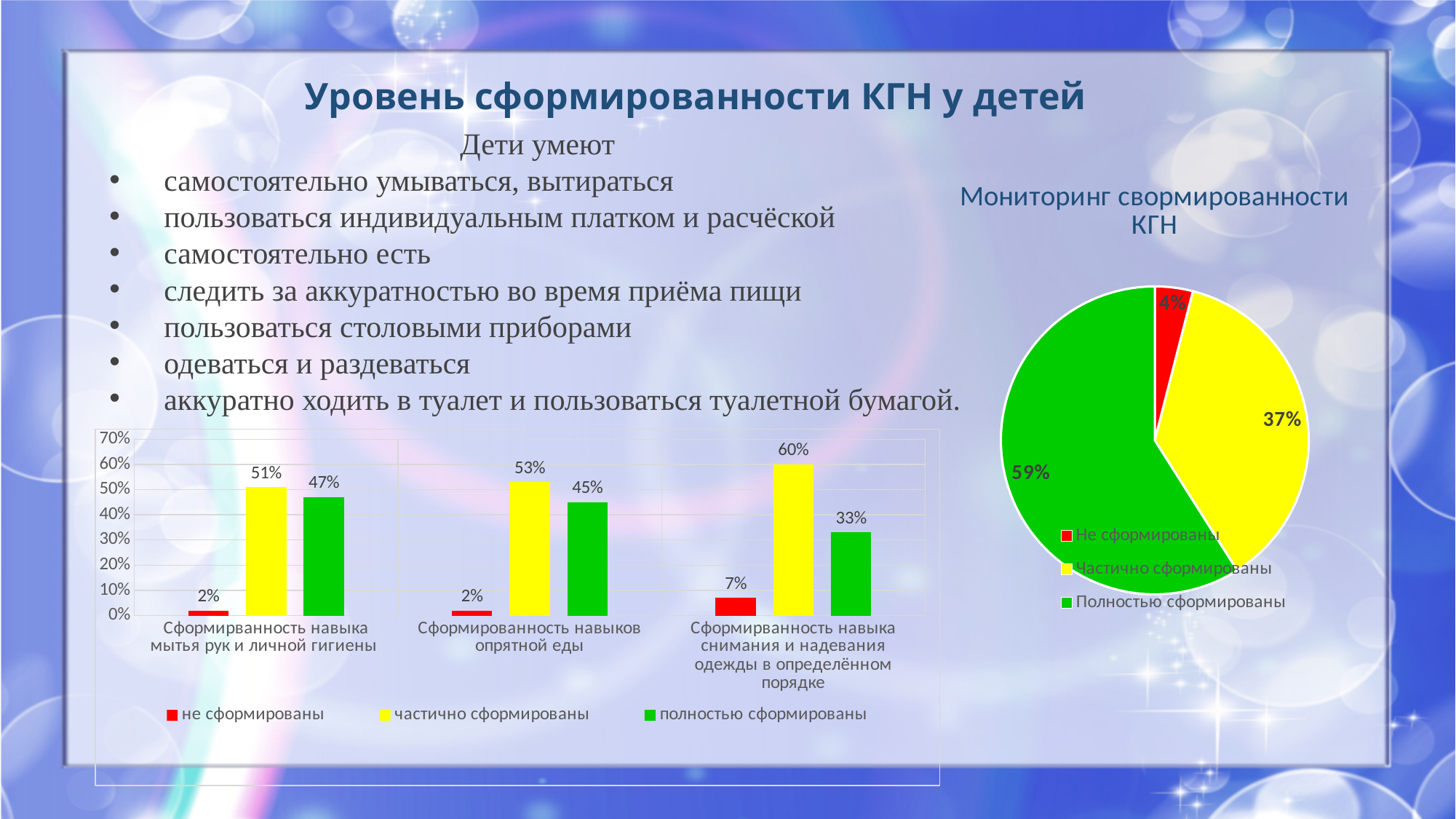
In the bar chart at the bottom left, what is the value for 'частично сформированы' for 'Сформирванность навыков опрятной еды'? 53% In the bar chart at the bottom left, which category has the highest value for 'частично сформированы'? Сформирванность навыка снимания и надевания одежды в определённом порядке In the bar chart at the bottom left, how many series does the legend list? 3 In the bar chart at the bottom left, which category has the lowest value for 'полностью сформированы'? Сформирванность навыка снимания и надевания одежды в определённом порядке In the chart titled 'Мониторинг сворми­рованности КГН', what is the difference between 'Полностью сформированы' and 'Частично сформированы'? 22% In the chart titled 'Мониторинг сворми­рованности КГН', which slice is the smallest? Не сформированы In the chart titled 'Мониторинг сворми­рованности КГН', what share of the pie is 'Полностью сформированы'? 59% In the bar chart at the bottom left, what is the value for 'не сформированы' for 'Сформирванность навыка мытья рук и личной гигиены'? 2% What kind of chart is shown on the right side of the slide? Pie chart In the bar chart at the bottom left, how many categories are shown on the x axis? 3 In the bar chart at the bottom left, what is the difference between 'частично сформированы' and 'полностью сформированы' for 'Сформирванность навыка мытья рук и личной гигиены'? 4% In the bar chart at the bottom left, what is the value for 'полностью сформированы' for 'Сформирванность навыка снимания и надевания одежды в определённом порядке'? 33%